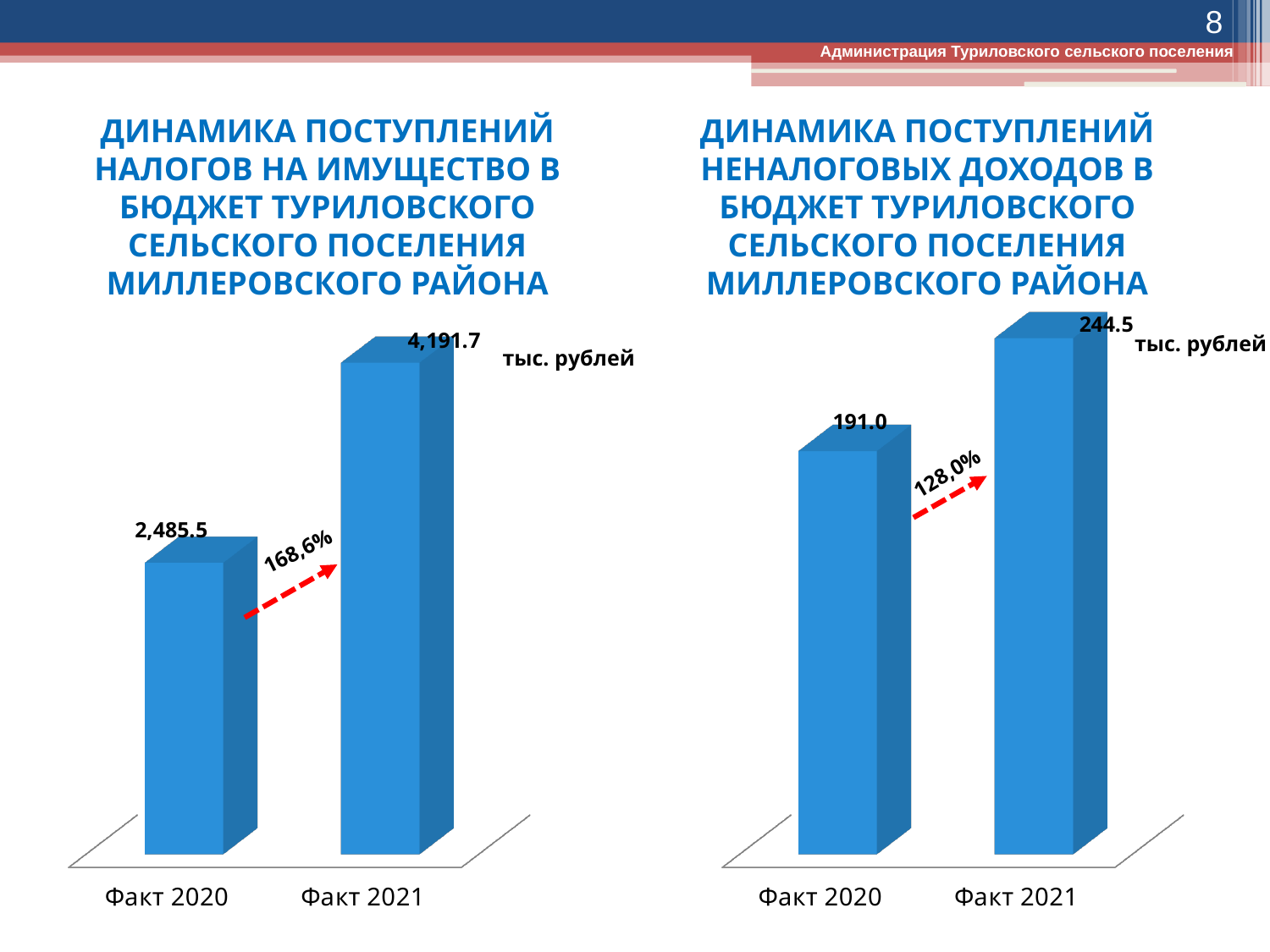
How many categories are shown in the left chart (property taxes)? 2 What growth percentage is shown on the arrow in the left chart (property taxes)? 168,6% In the right chart (non-tax revenues), what is the value for Факт 2021? 244.5 In the left chart (property taxes), what is the value for Факт 2020? 2,485.5 In the left chart (property taxes), which category has the highest value? Факт 2021 In the right chart (non-tax revenues), what is the difference between Факт 2021 and Факт 2020? 53.5 What kind of chart is the right chart (non-tax revenues)? Bar chart In the right chart (non-tax revenues), what is the value for Факт 2020? 191.0 In the right chart (non-tax revenues), which is larger, Факт 2020 or Факт 2021? Факт 2021 In the right chart (non-tax revenues), which category has the lowest value? Факт 2020 In the left chart (property taxes), what is the value for Факт 2021? 4,191.7 In the left chart (property taxes), what is the difference between Факт 2021 and Факт 2020? 1,706.2